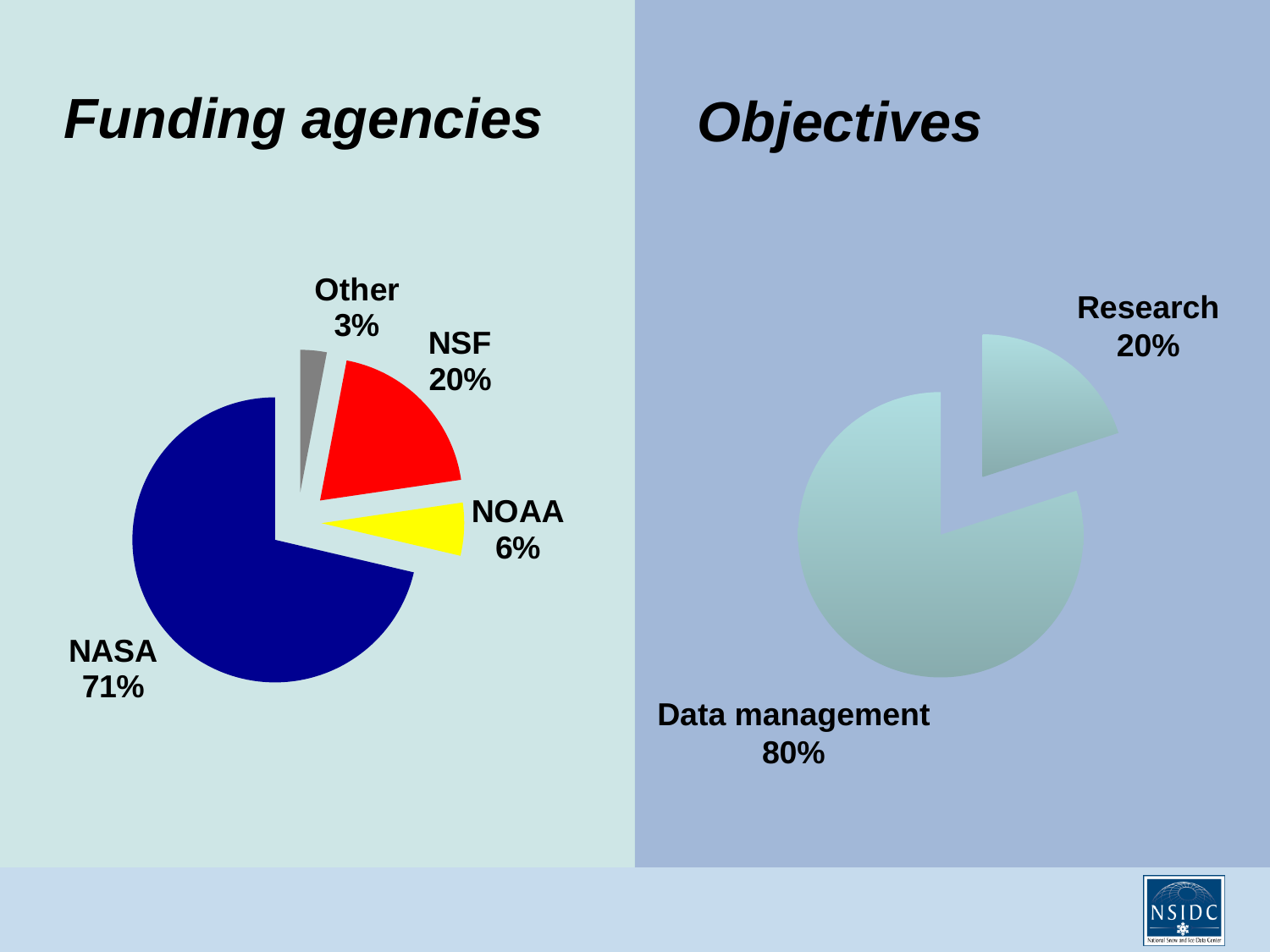
In the Objectives chart, what share does Data management have? 80% In the Funding agencies chart, what share does NSF have? 20% In the Funding agencies chart, which agency has the largest share? NASA How many slices does the Funding agencies chart have? 4 In the Objectives chart, what is the difference between Data management and Research? 60% What kind of chart is the Objectives chart? Pie chart In the Funding agencies chart, what share does NASA have? 71% In the Funding agencies chart, what is the difference between the NASA and NSF shares? 51% In the Funding agencies chart, which is larger, NOAA or Other? NOAA In the Funding agencies chart, what colour is the NASA slice? Dark blue In the Funding agencies chart, which category has the smallest share? Other In the Funding agencies chart, what share does NOAA have? 6%